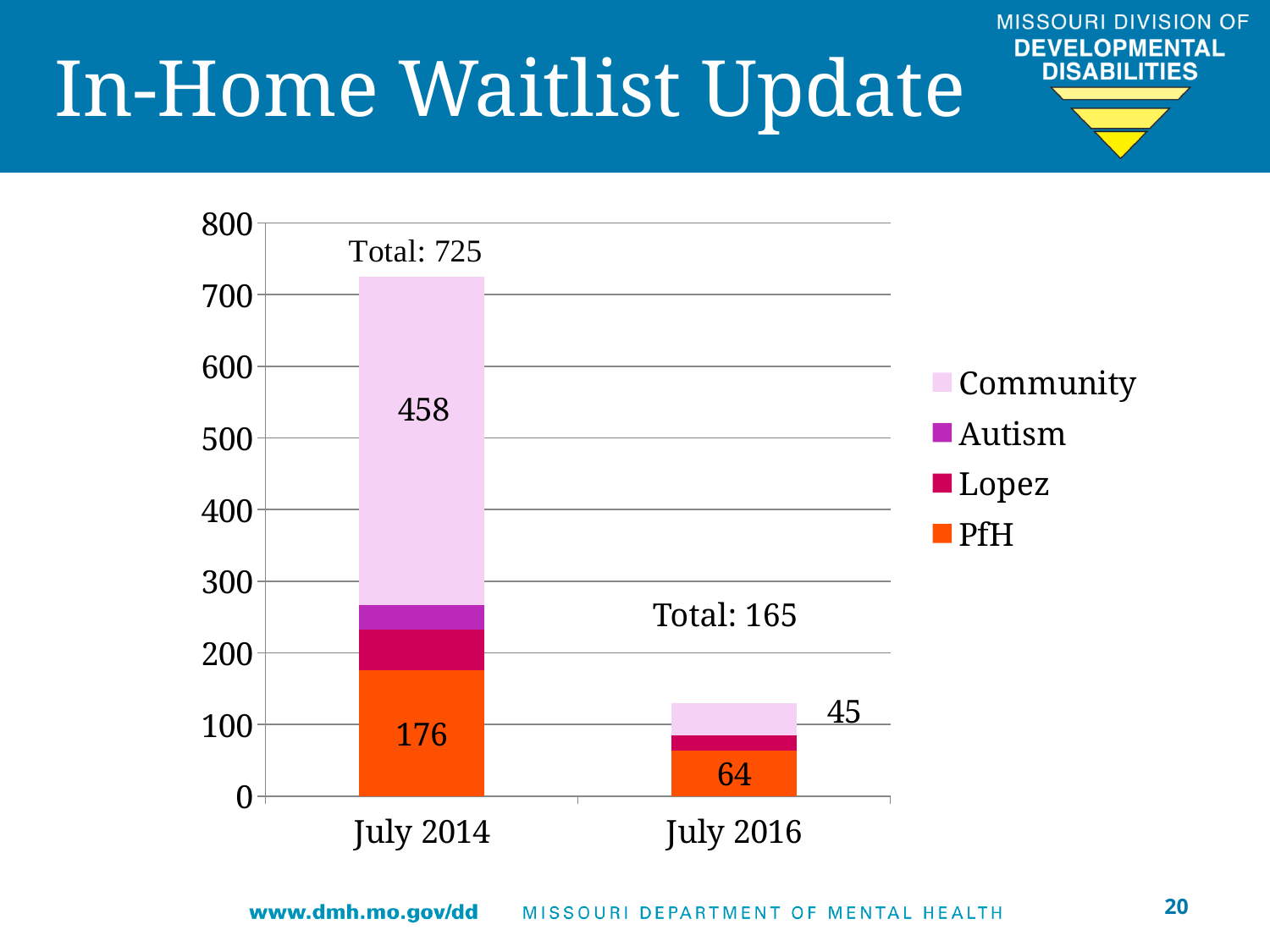
What is the total shown for the July 2014 bar? 725 By how much did the PfH value decrease from July 2014 to July 2016? 112 Does the total waitlist rise or fall from July 2014 to July 2016? Fall What is the PfH value for July 2016? 64 How many series does the legend list? 4 In July 2016, which is larger, the PfH value or the Community value? PfH What is the Community value for July 2014? 458 What is the difference between the Community values for July 2014 and July 2016? 413 What kind of chart is shown on the slide? Stacked bar chart What is the PfH value for July 2014? 176 What is the total shown for the July 2016 bar? 165 What is the Community value for July 2016? 45